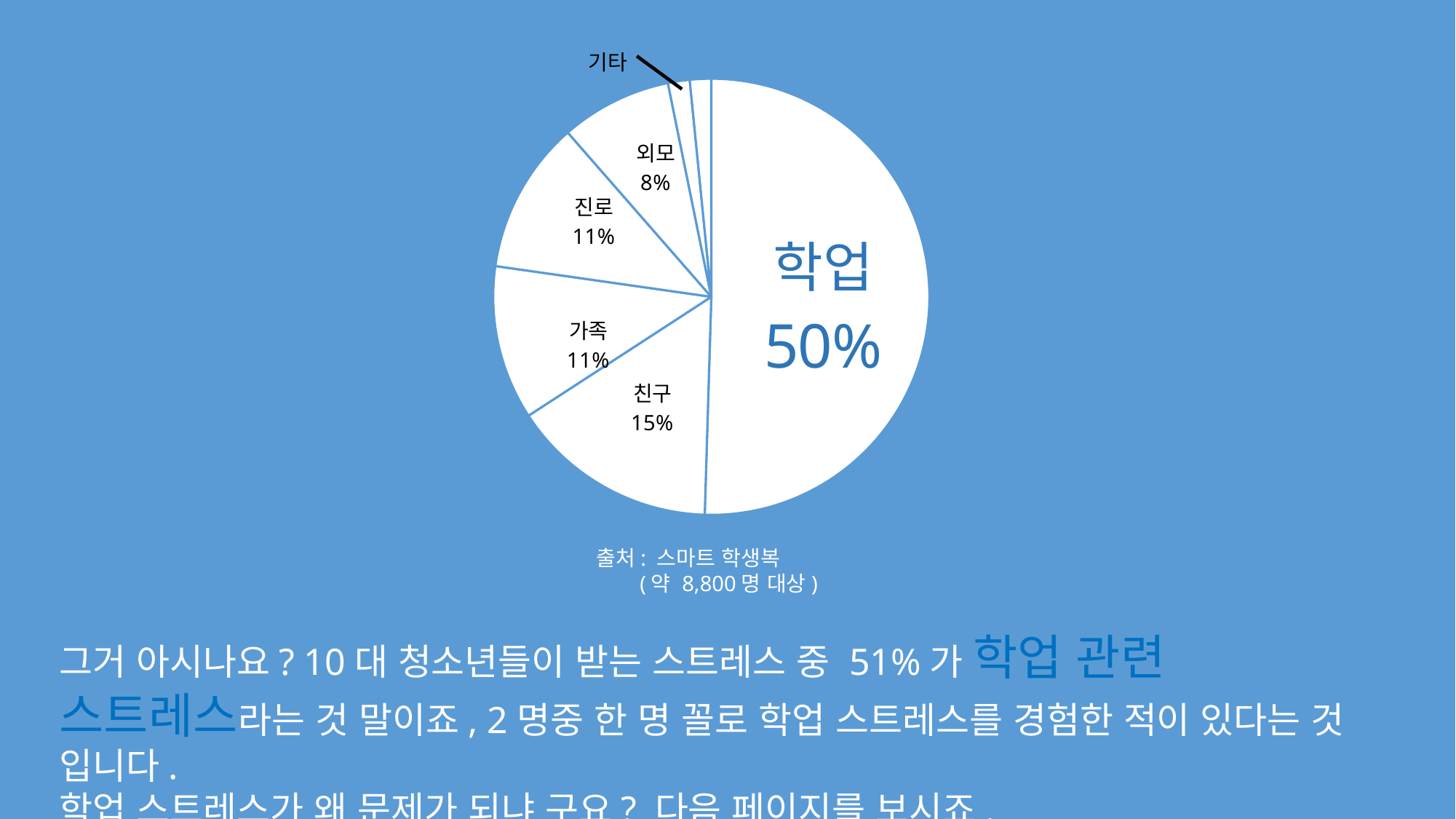
What kind of chart is shown on the slide? pie chart What percentage of the pie chart is the 학업 slice? 50% What is the difference in percentage points between 학업 and 친구? 35% What is the difference between the 친구 slice and the 외모 slice? 7% According to the note under the chart, what is the source of the data? 스마트 학생복 What percentage is labelled on the 외모 slice? 8% What is the value shown for 진로? 11% Which category has the largest slice of the pie? 학업 What share of the pie do 학업 and 친구 make up together? 65% What is the value shown for 가족? 11% What percentage does the 친구 slice represent? 15% Which slice is larger, 친구 or 진로? 친구